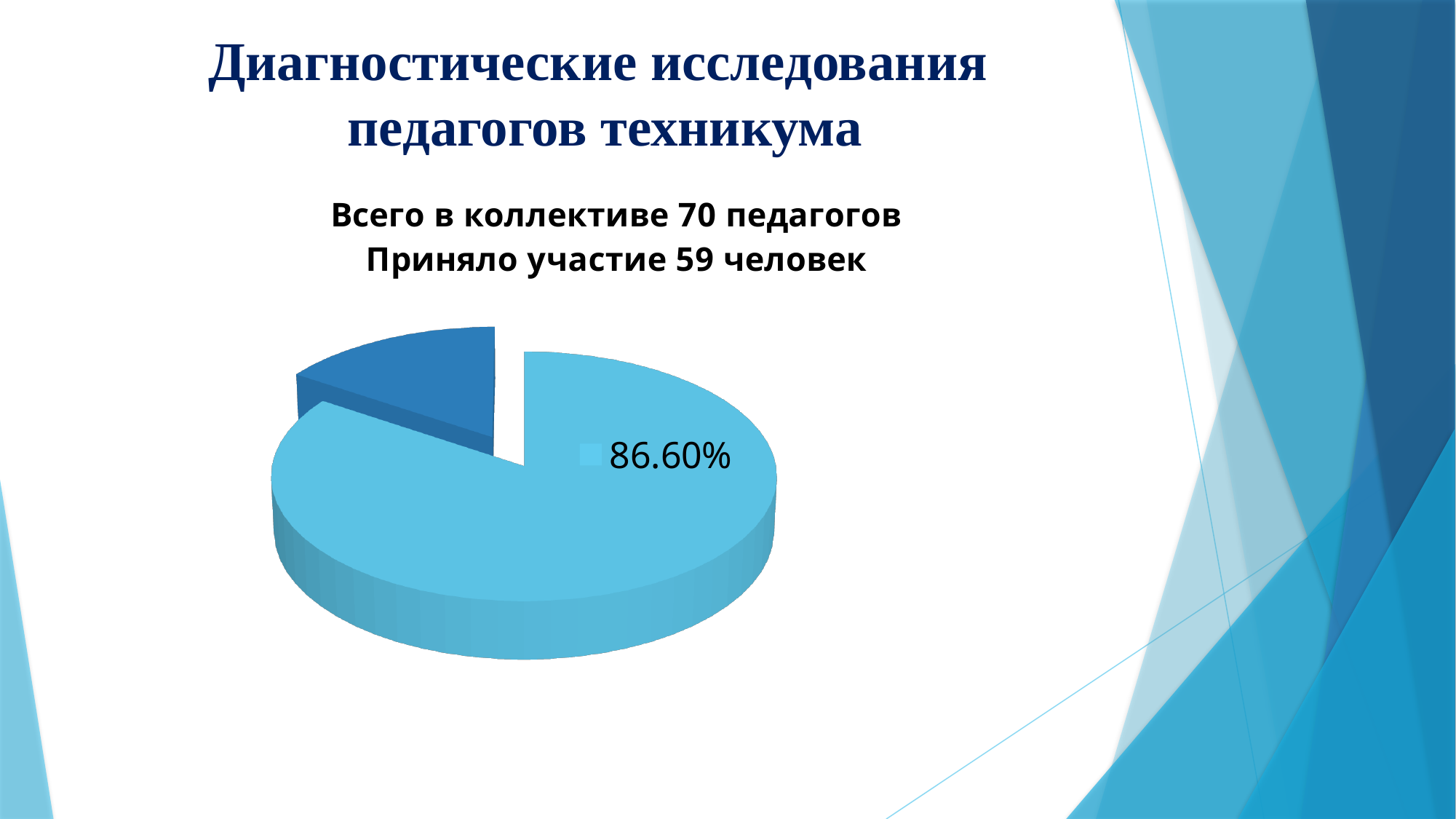
What kind of chart is shown on the slide? pie chart What share of the pie does the large light blue slice represent? 86.60% How many slices does the pie chart have? 2 Which colour is the largest slice of the pie chart? light blue How many entries does the chart legend list? 1 According to the text above the chart, how many teachers are in the collective in total? 70 Which slice of the pie is larger, the light blue one or the dark blue one? the light blue one Which colour is the smallest slice of the pie chart? dark blue What is the legend entry shown next to the pie chart? 86.60%